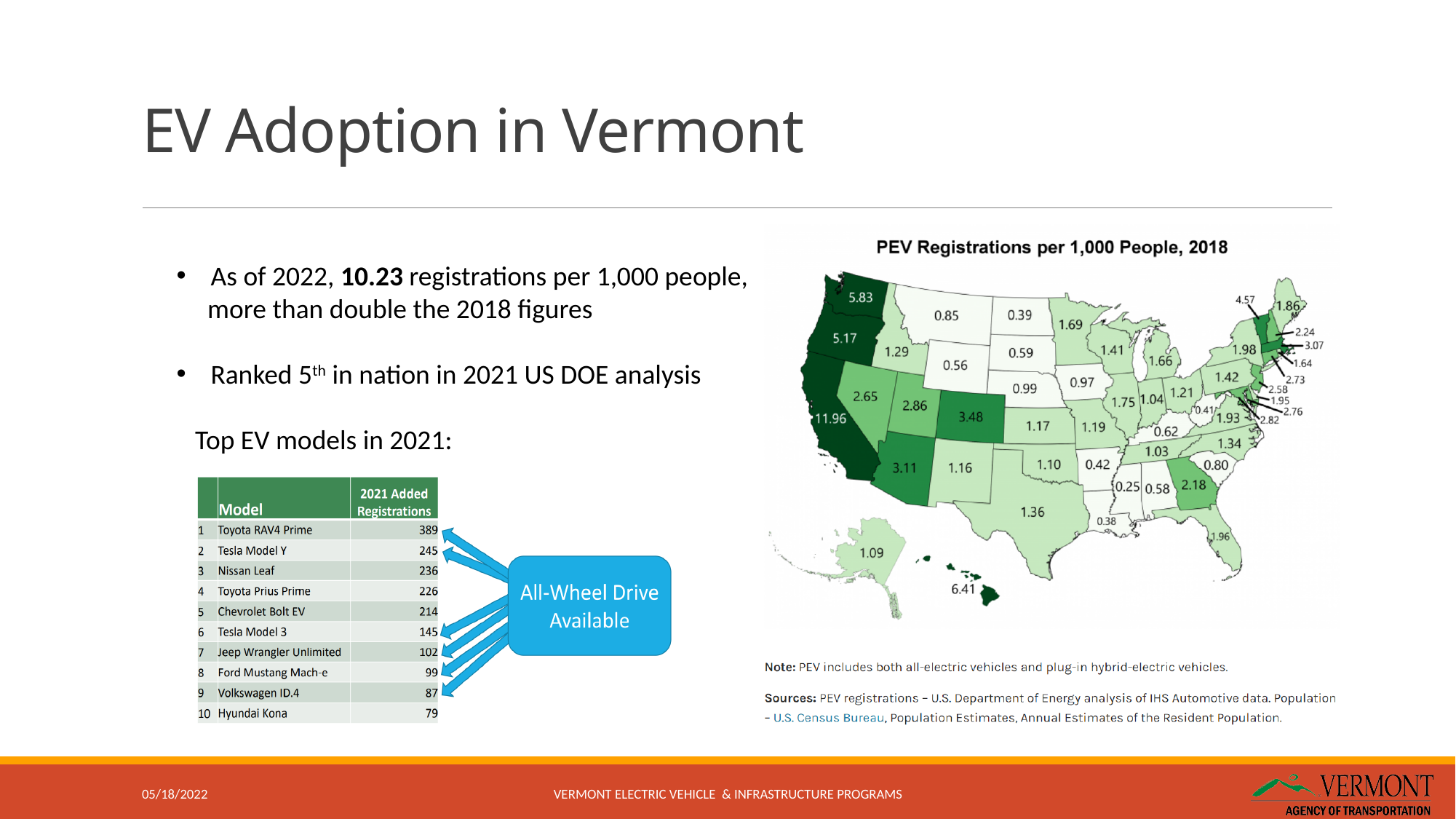
In the Top EV models in 2021 table, how many 2021 added registrations are listed for the Nissan Leaf? 236 On the PEV Registrations per 1,000 People, 2018 map, what is the value shown for Vermont? 4.57 On the PEV Registrations per 1,000 People, 2018 map, which has a higher value, Washington or Oregon? Washington (5.83) On the PEV Registrations per 1,000 People, 2018 map, which state has the highest value? California (11.96) On the PEV Registrations per 1,000 People, 2018 map, what is the value shown for Texas? 1.36 What kind of chart is shown on the right side of the slide? A map (choropleth map of the United States) What is the title of the map chart on the right side of the slide? PEV Registrations per 1,000 People, 2018 In the Top EV models in 2021 table, which model has the most 2021 added registrations? Toyota RAV4 Prime (389) On the PEV Registrations per 1,000 People, 2018 map, which state has the lowest value? Mississippi (0.25) How many models are listed in the Top EV models in 2021 table? 10 On the PEV Registrations per 1,000 People, 2018 map, what is the difference between California's value and Washington's value? 6.13 On the PEV Registrations per 1,000 People, 2018 map, what is the value shown for Hawaii? 6.41